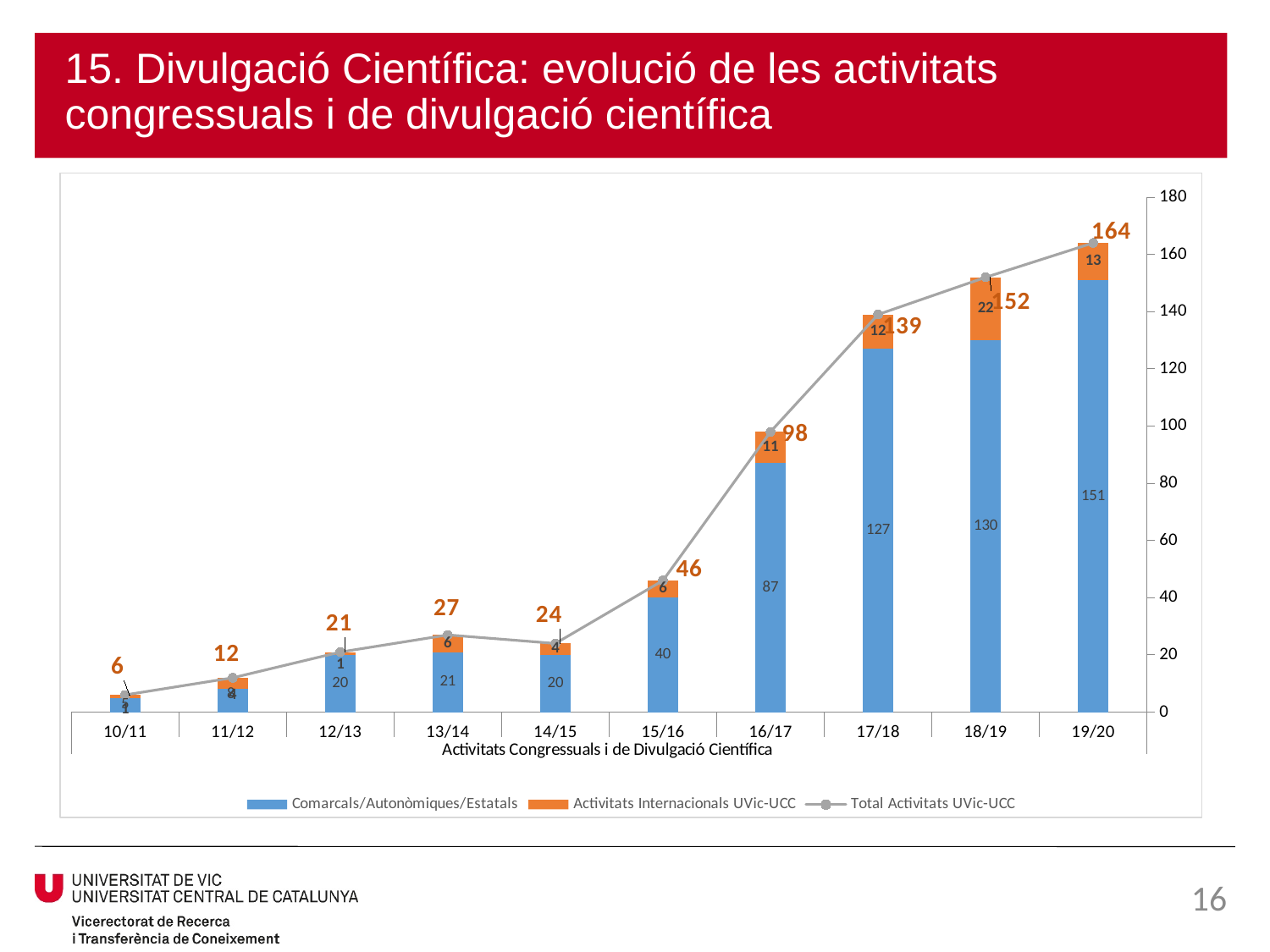
What is the Activitats Internacionals UVic-UCC value for 18/19? 22 What is the Comarcals/Autonòmiques/Estatals value for 16/17? 87 What is the Total Activitats UVic-UCC value for 19/20? 164 What is the difference between the Total Activitats UVic-UCC for 19/20 and 18/19? 12 Which year has the highest Total Activitats UVic-UCC? 19/20 How many series does the legend list? 3 What is the Total Activitats UVic-UCC value for 14/15? 24 How many academic years are shown on the x axis? 10 What kind of chart is shown on the slide? bar chart (stacked bars with a total line) Do the Total Activitats UVic-UCC values generally rise or fall from 10/11 to 19/20? rise Which year has the larger Activitats Internacionals UVic-UCC value, 18/19 or 19/20? 18/19 Which year has the lowest Total Activitats UVic-UCC? 10/11